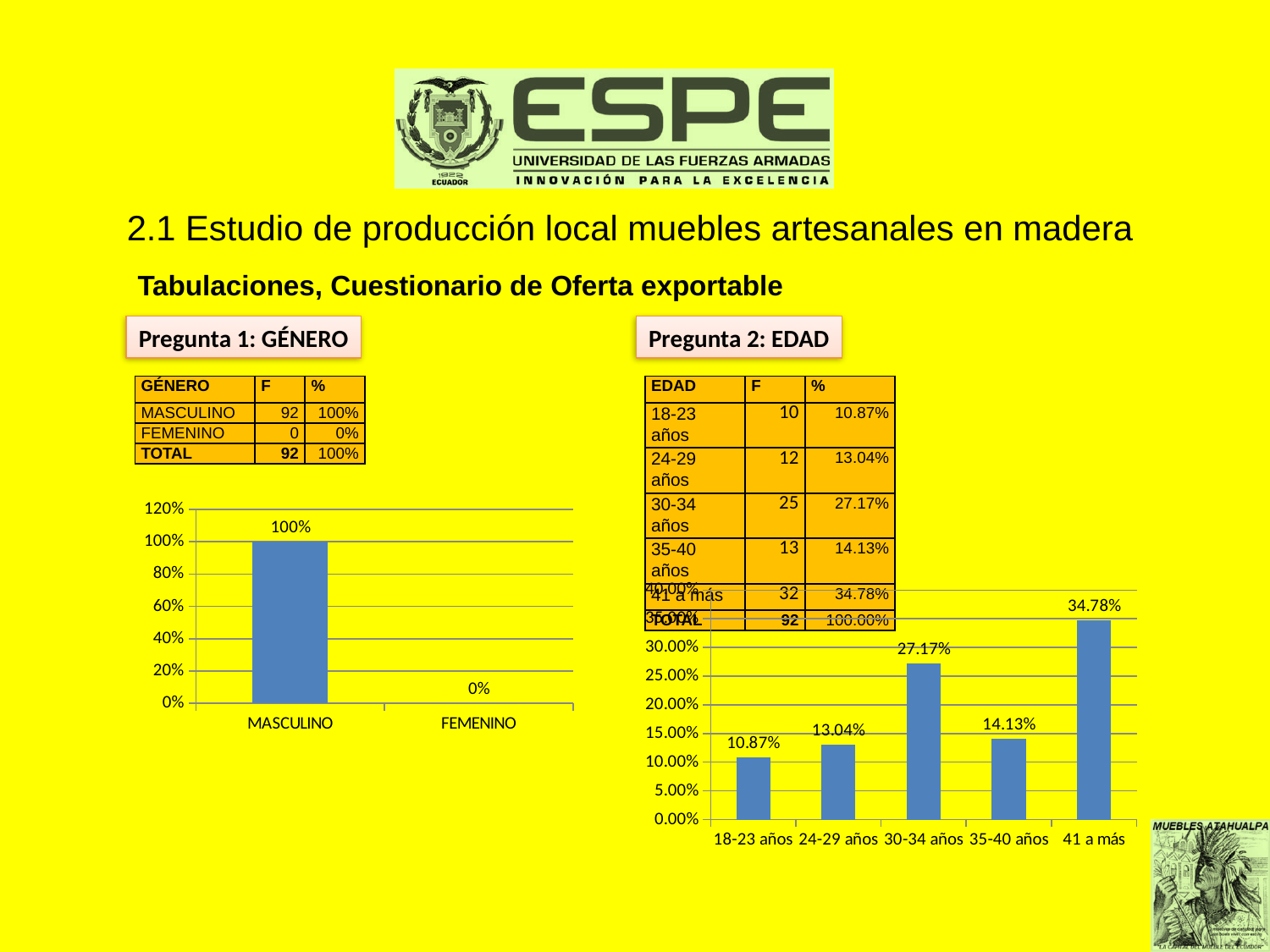
In the left chart (Pregunta 1: GÉNERO), what is the value for FEMENINO? 0% In the right chart (Pregunta 2: EDAD), is the value for 41 a más greater or less than 30.00%? greater In the left chart (Pregunta 1: GÉNERO), what is the value for MASCULINO? 100% In the right chart (Pregunta 2: EDAD), what is the value for 30-34 años? 27.17% In the right chart (Pregunta 2: EDAD), what is the value for 18-23 años? 10.87% In the left chart (Pregunta 1: GÉNERO), how many categories are shown on the x axis? 2 What kind of chart is the left chart (Pregunta 1: GÉNERO)? bar chart In the right chart (Pregunta 2: EDAD), which age group has the highest value? 41 a más In the right chart (Pregunta 2: EDAD), which is larger: the value for 24-29 años or the value for 35-40 años? 35-40 años In the right chart (Pregunta 2: EDAD), which age group has the lowest value? 18-23 años In the right chart (Pregunta 2: EDAD), how many age groups are shown on the x axis? 5 In the right chart (Pregunta 2: EDAD), what is the difference between the values for 41 a más and 30-34 años? 7.61%